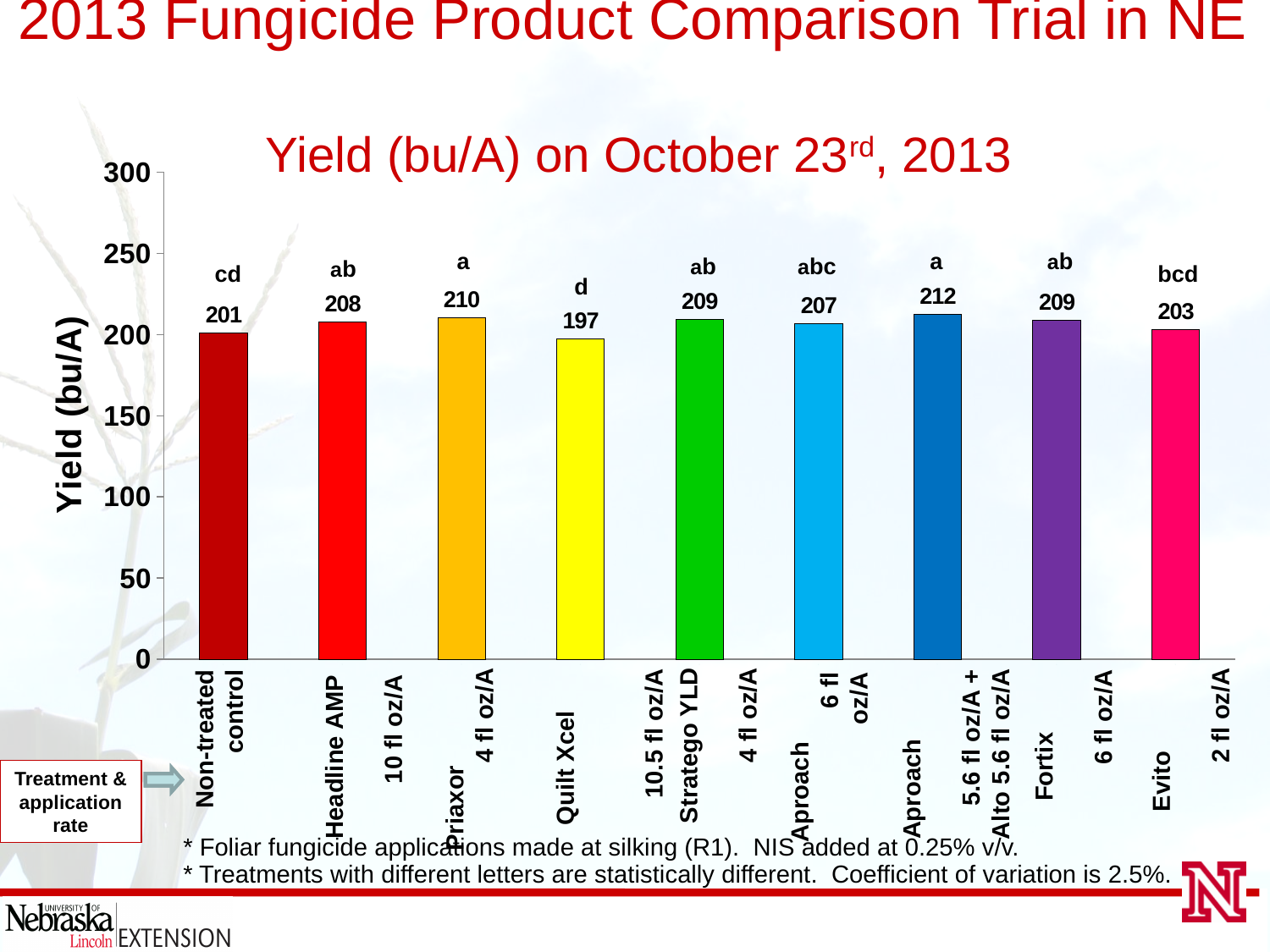
What is the yield for Quilt Xcel? 197 Is the yield for Fortix greater or less than 150? greater What is the yield for Priaxor? 210 What kind of chart is shown on the slide? bar chart Which treatment has the lowest yield? Quilt Xcel What is the difference in yield between the Aproach + Alto treatment and Quilt Xcel? 15 Which has the higher yield, Headline AMP or the Non-treated control? Headline AMP What is the yield for Evito? 203 Which treatment has the highest yield? Aproach 5.6 fl oz/A + Alto 5.6 fl oz/A What is the yield for the Non-treated control? 201 What is the title of the chart? Yield (bu/A) on October 23rd, 2013 How many treatments are shown in the chart? 9